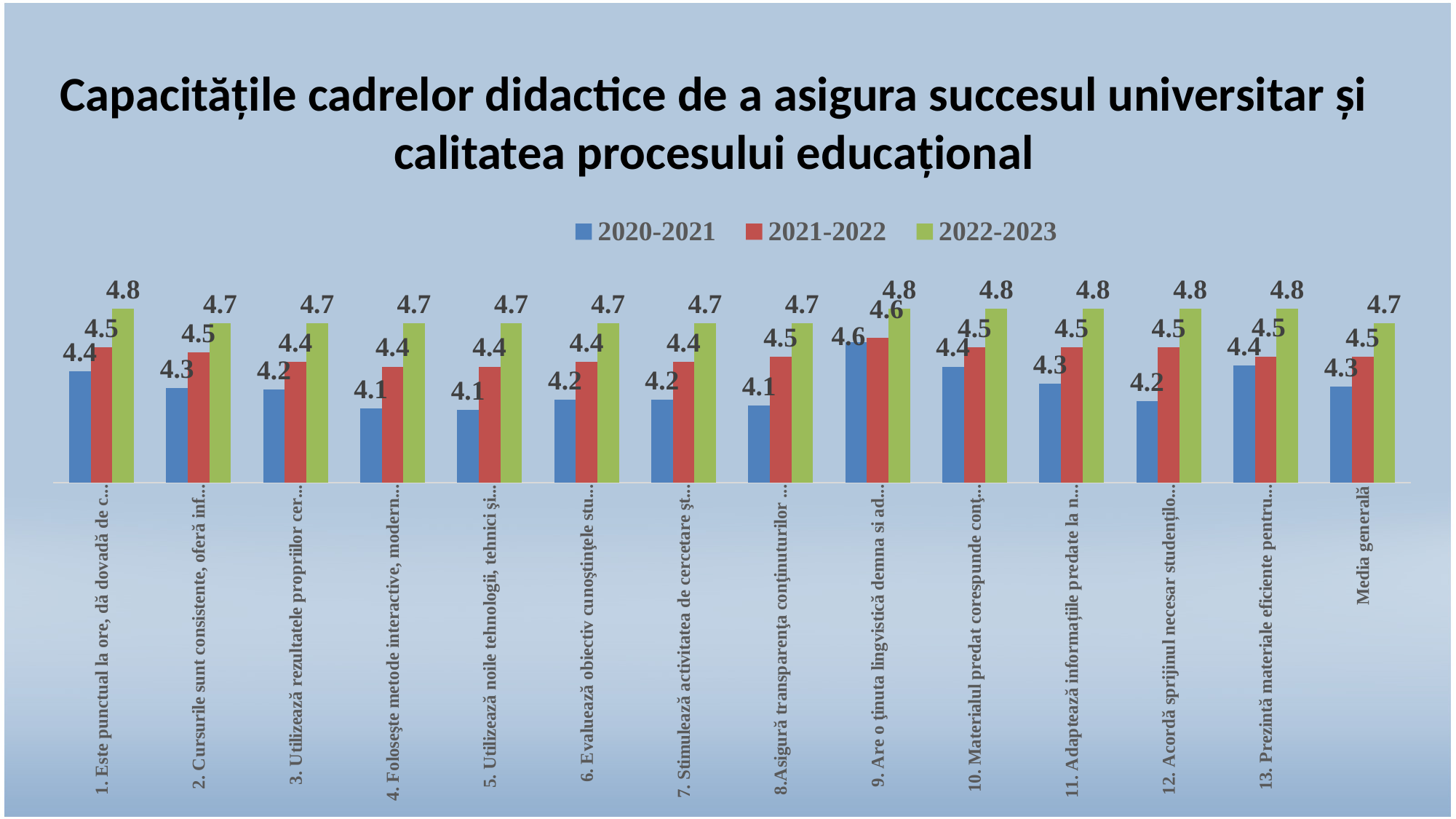
What is the difference between the 2022-2023 and 2020-2021 values for category 8 ('Asigură transparența conținuturilor...')? 0.6 What is the value for 'Media generală' in the 2022-2023 series? 4.7 What is the value for 'Media generală' in the 2020-2021 series? 4.3 How many series does the legend list? 3 What type of chart is shown on the slide? bar chart Which category has the highest 2020-2021 value? 9. Are o ținuta lingvistică demna si ad... What is the 2020-2021 value for category 9 ('Are o ținuta lingvistică demna si ad...')? 4.6 What is the 2021-2022 value for category 1 ('Este punctual la ore, dă dovadă de c...')? 4.5 For category 4 ('Folosește metode interactive, modern...'), do the values rise or fall from 2020-2021 to 2022-2023? rise For 'Media generală', which series has the larger value: 2020-2021 or 2021-2022? 2021-2022 Which colour represents the 2022-2023 series in the legend? green How many categories are shown along the x axis? 14